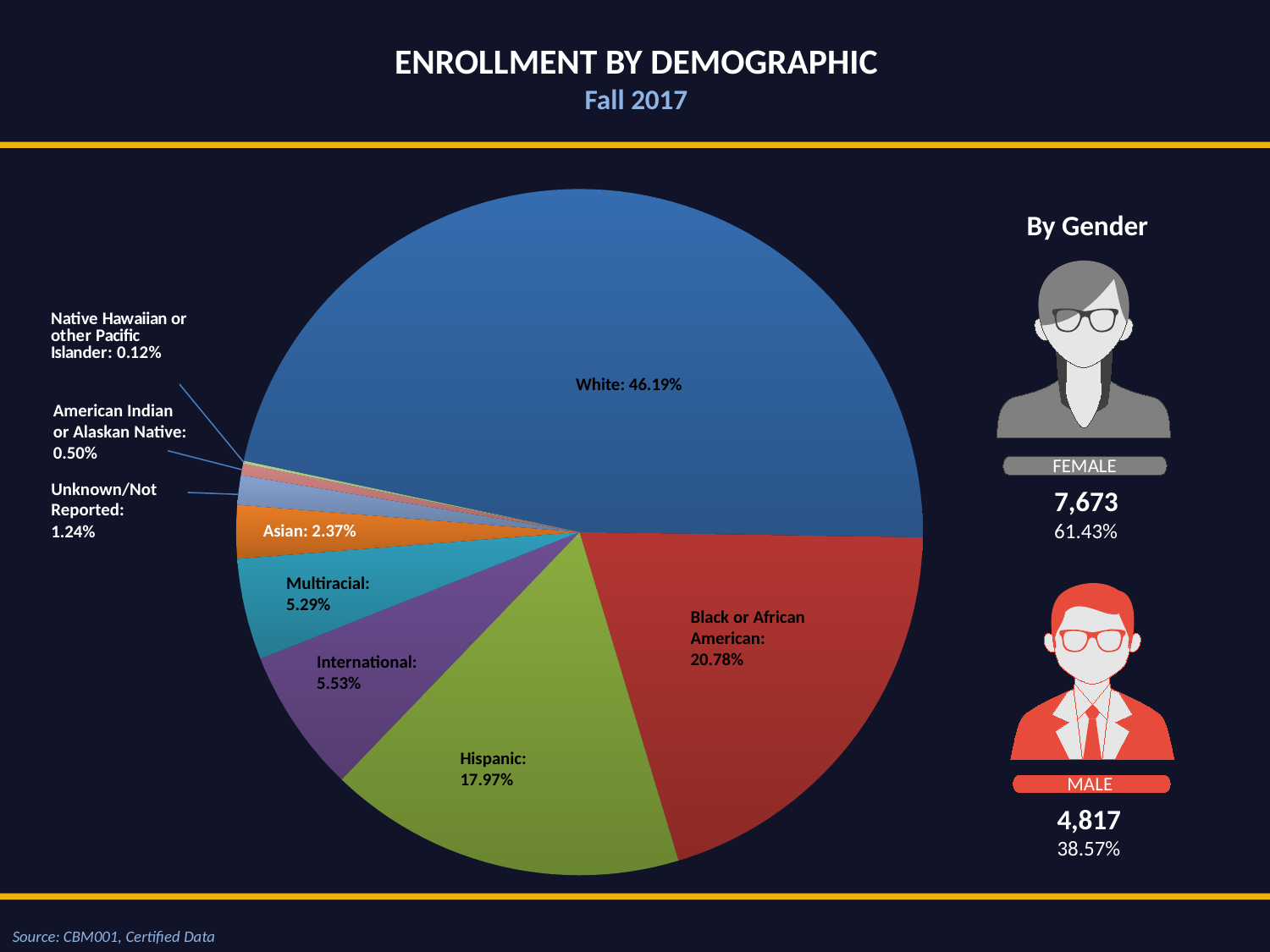
Which demographic group has the smallest share of enrollment? Native Hawaiian or other Pacific Islander What type of chart is used to show enrollment by demographic? pie chart What share of enrollment is Hispanic? 17.97% What share of enrollment is Native Hawaiian or other Pacific Islander? 0.12% What share of enrollment is White? 46.19% Which demographic group has the largest share of enrollment? White What is the difference in percentage points between the Black or African American share and the Hispanic share? 2.81 What share of enrollment is Black or African American? 20.78% What share of enrollment is Multiracial? 5.29% Which is larger, the International share or the Multiracial share? International What is the subtitle of the slide indicating the term of the enrollment data? Fall 2017 How many demographic categories are shown in the pie chart? 9